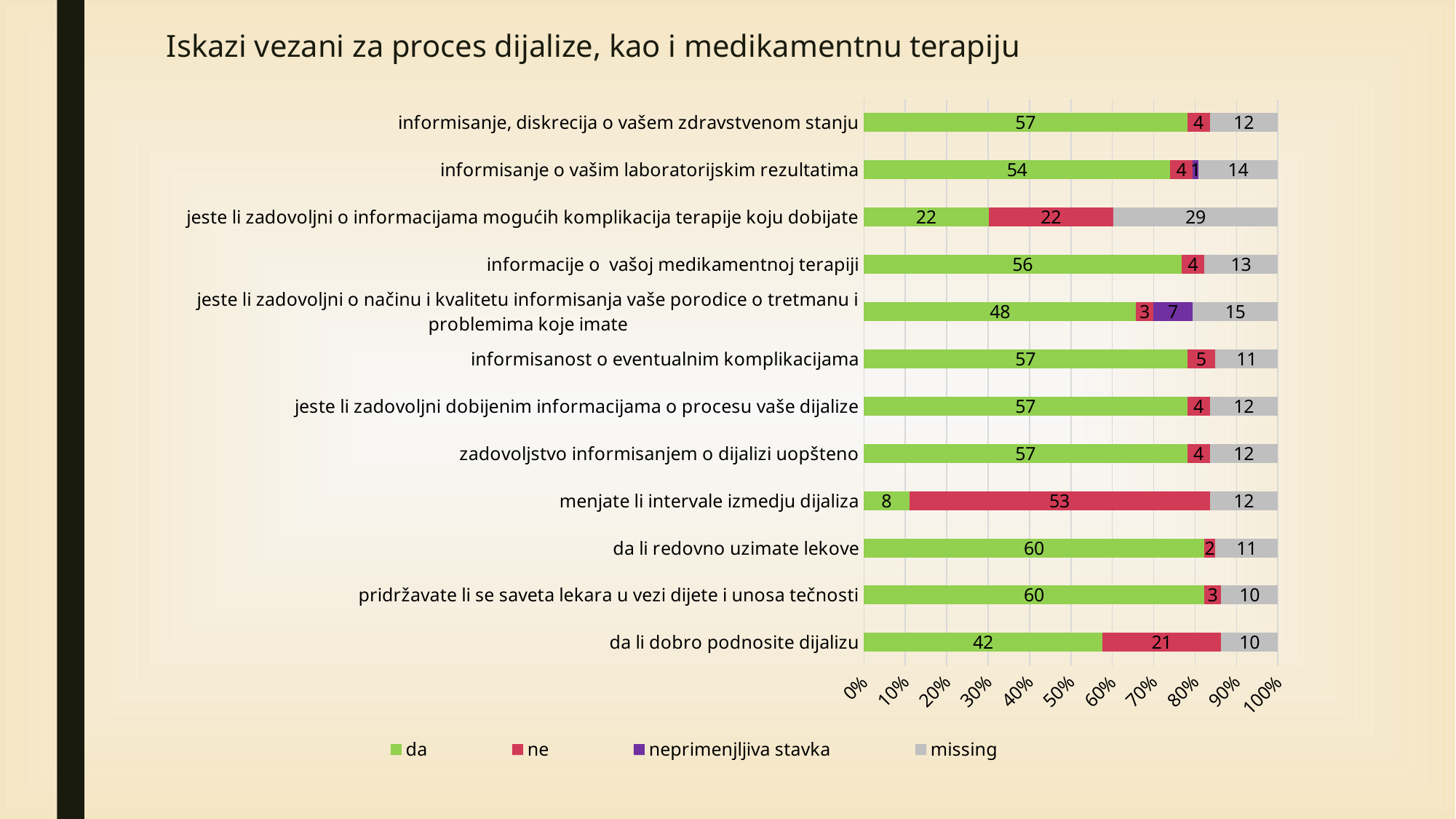
What is the 'missing' value for 'jeste li zadovoljni o informacijama mogućih komplikacija terapije koju dobijate'? 29 What is the difference between the 'da' and 'ne' values for 'da li dobro podnosite dijalizu'? 21 What kind of chart is shown on the slide? stacked bar chart How many categories (statements) are shown on the chart? 12 Which category has the highest 'ne' value? menjate li intervale izmedju dijaliza How many series does the legend list? 4 What is the 'ne' value for 'menjate li intervale izmedju dijaliza'? 53 Which is larger for 'menjate li intervale izmedju dijaliza': the 'da' value or the 'ne' value? ne What is the 'neprimenjljiva stavka' value for 'jeste li zadovoljni o načinu i kvalitetu informisanja vaše porodice o tretmanu i problemima koje imate'? 7 Which category has the lowest 'da' value? menjate li intervale izmedju dijaliza What is the 'da' value for 'da li dobro podnosite dijalizu'? 42 What is the total of the stacked bar for 'da li redovno uzimate lekove'? 73